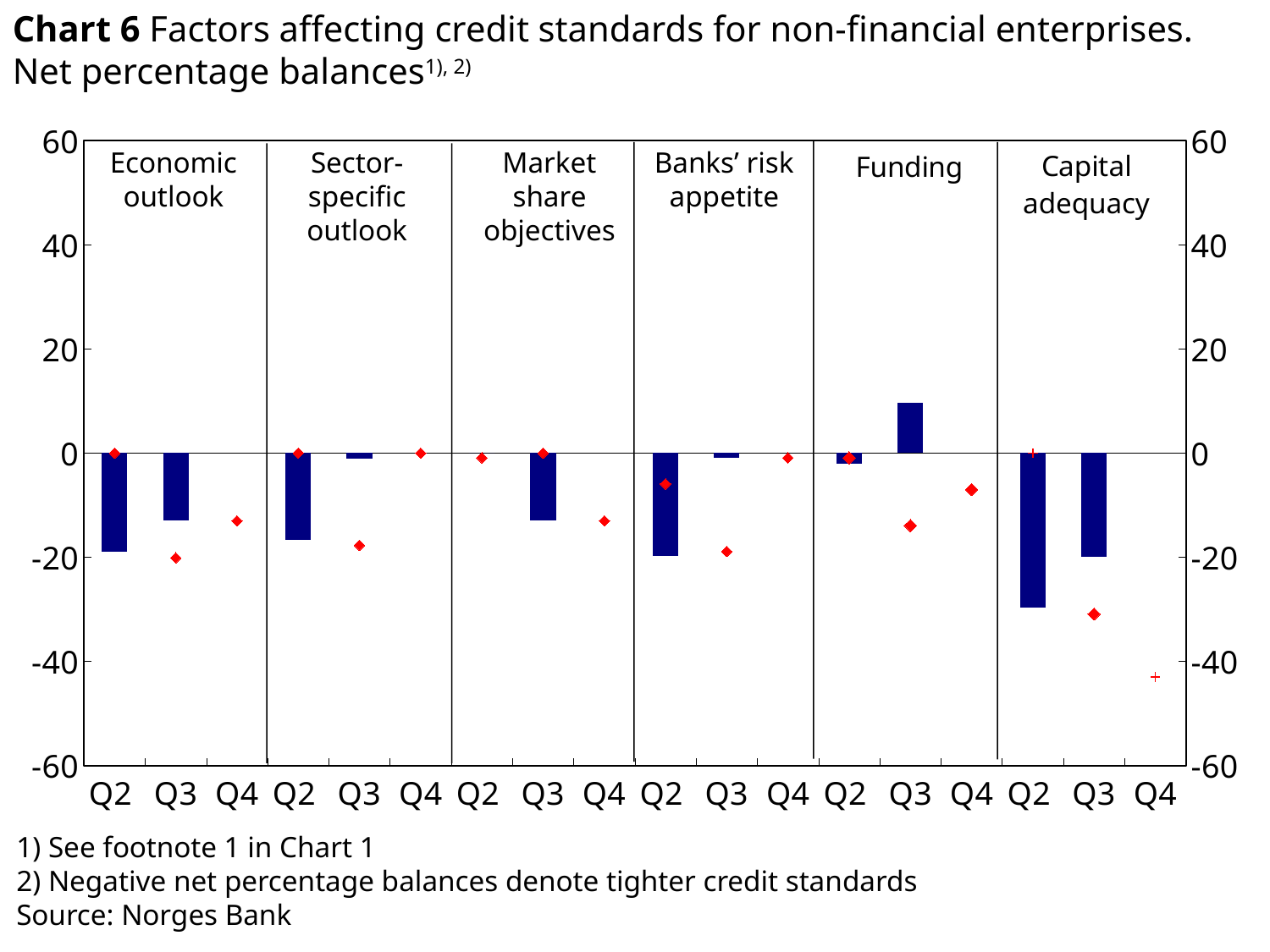
Which factor has the lowest Q2 bar? Capital adequacy What kind of chart is shown on the slide? Combination bar and marker chart (bars with red diamond markers) According to the footnote, what do negative net percentage balances denote? Tighter credit standards Which factor is the only one with a bar above zero? Funding How many factor panels are shown in the chart? 6 Is the Q2 bar for Banks' risk appetite greater or less than -10? less Is the Q3 bar for Funding greater or less than 0? greater Is the Q4 marker for Capital adequacy greater or less than -40? less For Economic outlook, which bar is lower, Q2 or Q3? Q2 How many quarters are shown on the x axis within each factor panel? 3